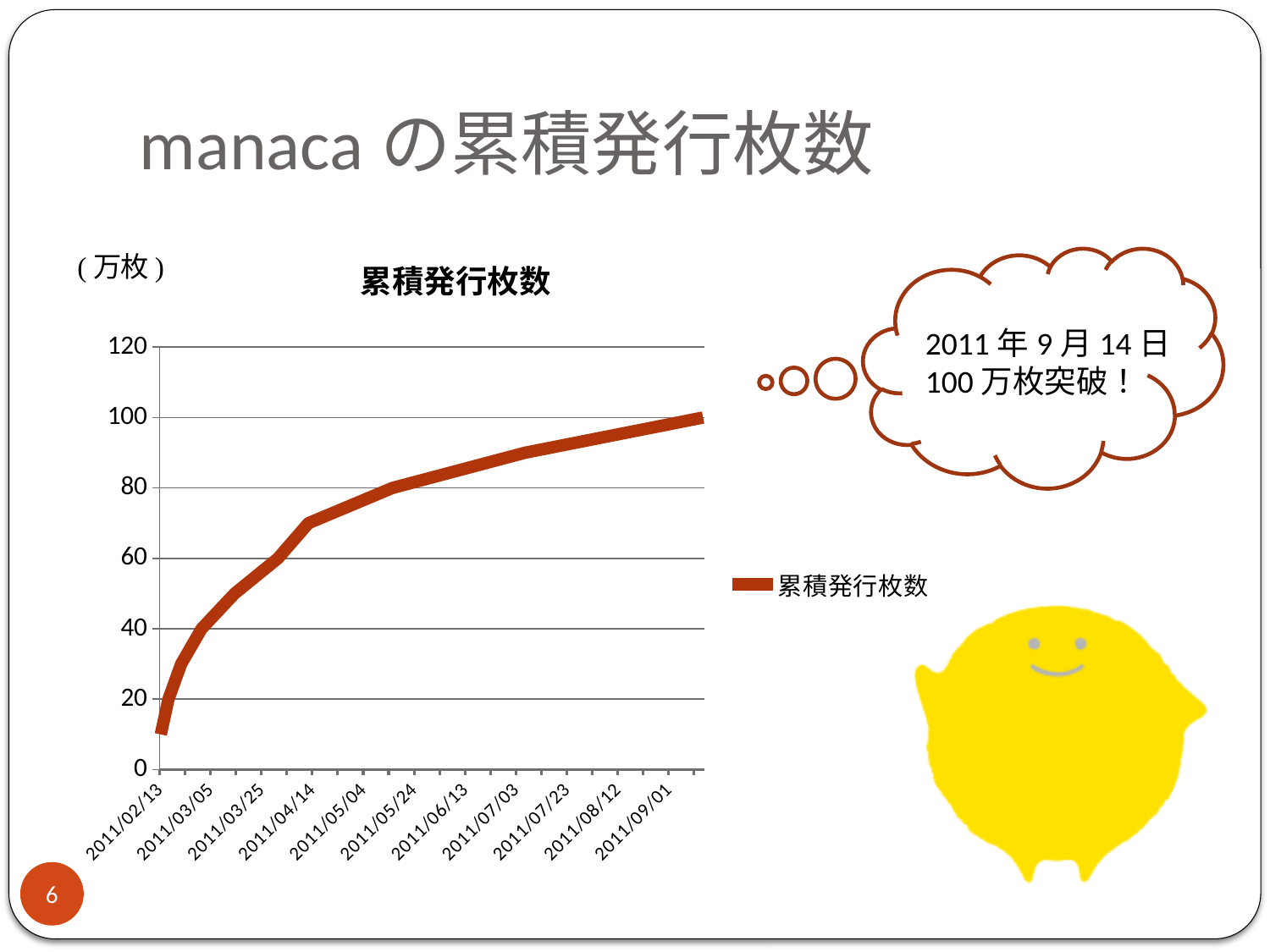
Is the value for 2011/09/01 greater or less than 80? greater What kind of chart is shown on the slide? line chart Do the values rise or fall along the x axis from 2011/02/13 to 2011/09/01? rise What is the title of the chart? 累積発行枚数 Is the value for 2011/05/24 greater or less than 60? greater What unit is shown for the y axis of the chart? 万枚 How many series does the chart legend list? 1 Is the value for 2011/04/14 greater or less than 60? greater At which date label on the x axis is the plotted value lowest? 2011/02/13 How many date labels are shown on the x axis? 11